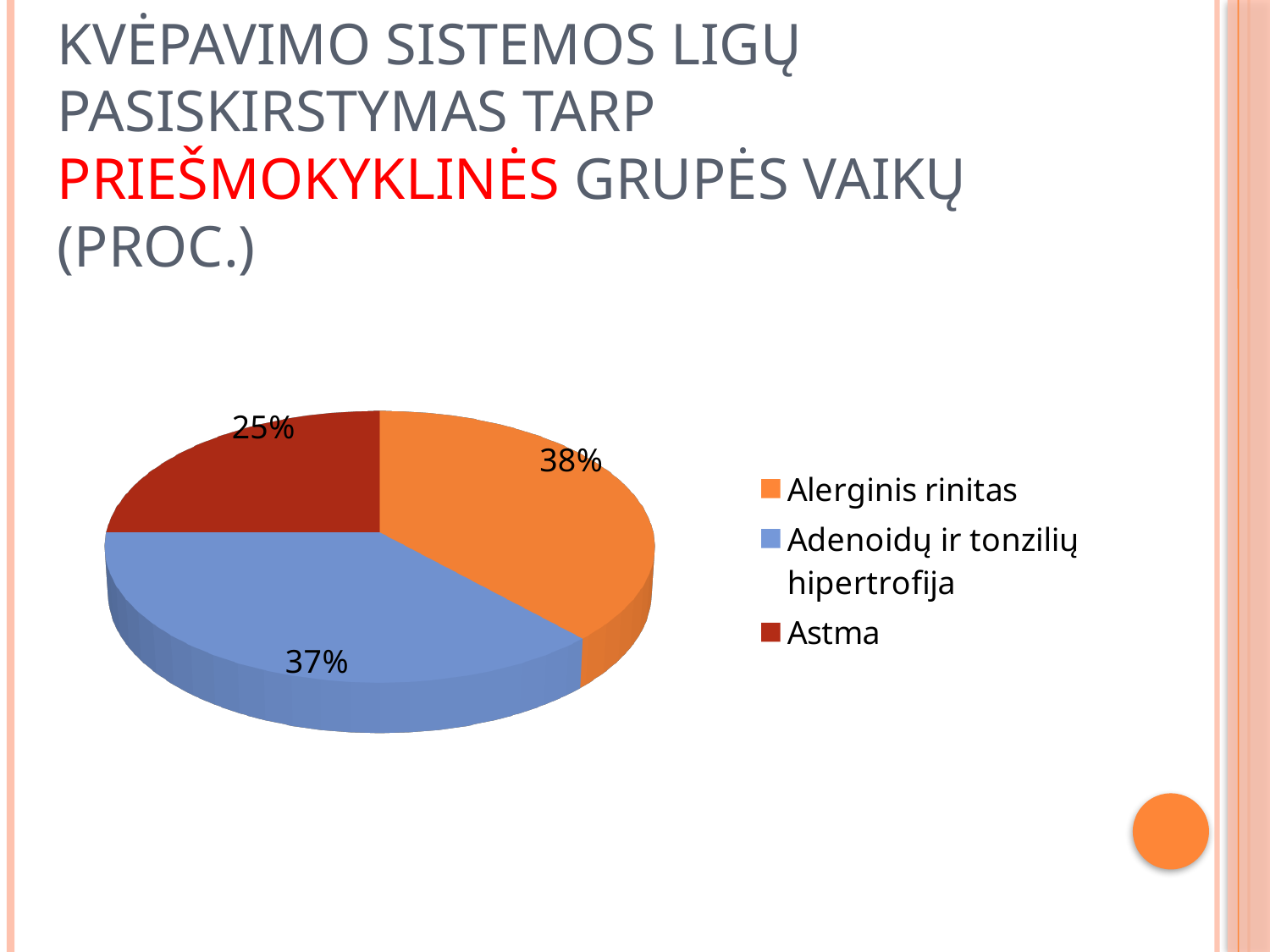
What colour is the slice for Astma in the pie chart? Dark red How many slices does the pie chart have? 3 What share of the pie does Astma represent? 25% What is the difference in percentage points between Adenoidų ir tonzilių hipertrofija and Astma? 12 What is the difference in percentage points between Alerginis rinitas and Astma? 13 What percentage of the pie chart is Adenoidų ir tonzilių hipertrofija? 37% Which is larger: the slice for Adenoidų ir tonzilių hipertrofija or the slice for Astma? Adenoidų ir tonzilių hipertrofija What percentage of the pie chart is Alerginis rinitas? 38% What percentage of the pie chart is Astma? 25% Which category has the largest slice of the pie chart? Alerginis rinitas What type of chart is shown on the slide? Pie chart Which category has the smallest slice of the pie chart? Astma